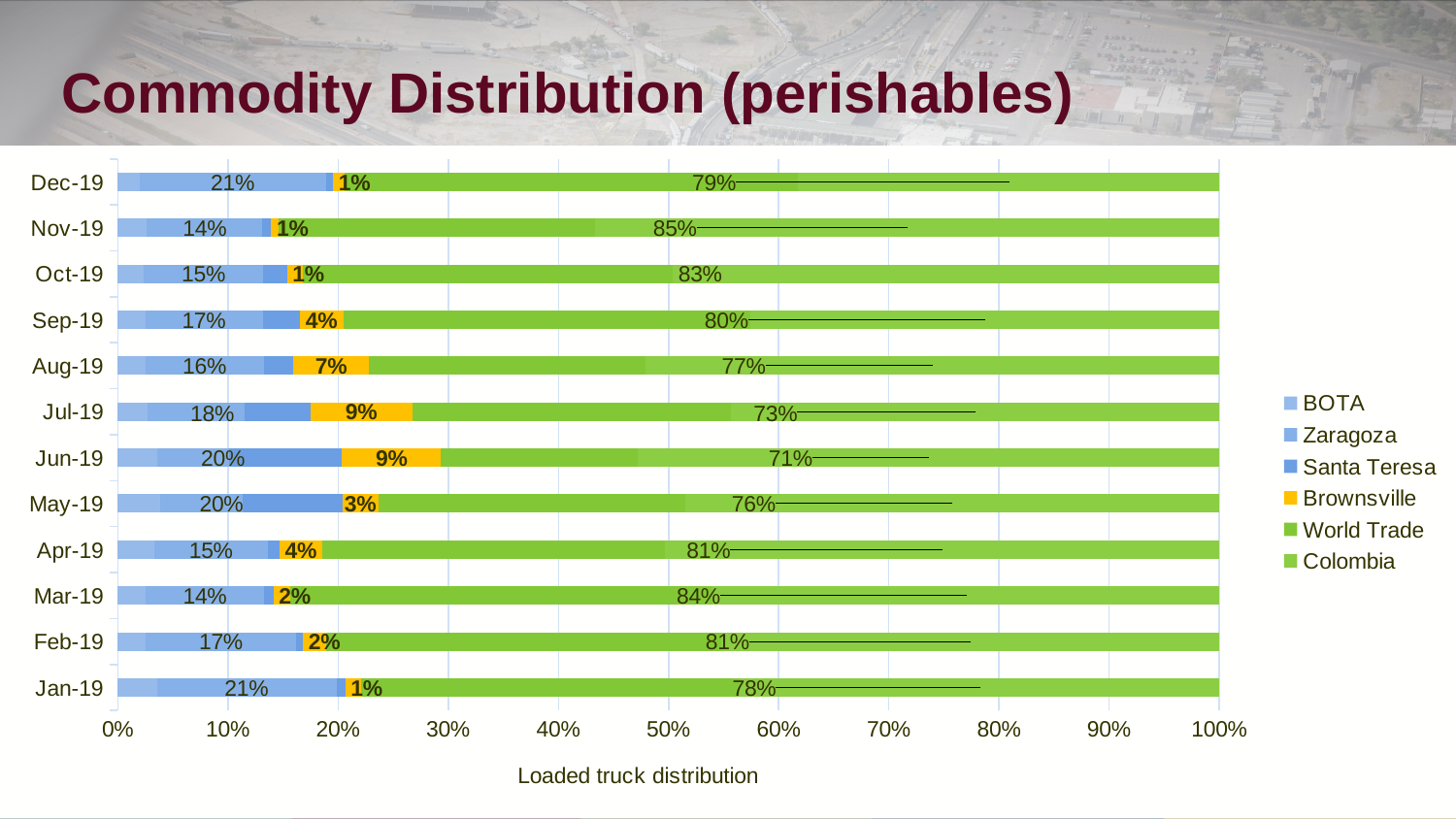
What is the Brownsville (orange) value for Aug-19? 7% Which month has the larger Brownsville value, Aug-19 or May-19? Aug-19 How many months (categories) are shown on the chart? 12 What is the Brownsville (orange) value for Jul-19? 9% What is the label on the horizontal axis of the chart? Loaded truck distribution What is the Brownsville (orange) value for May-19? 3% How many series does the legend list? 6 What is the title of the chart on the slide? Commodity Distribution (perishables) What is the difference between the Brownsville values for Aug-19 and Sep-19? 3% What type of chart is shown on the slide? Stacked bar chart What value is printed on the green segment of the Nov-19 bar? 85% What value is printed on the blue portion of the Dec-19 bar? 21%